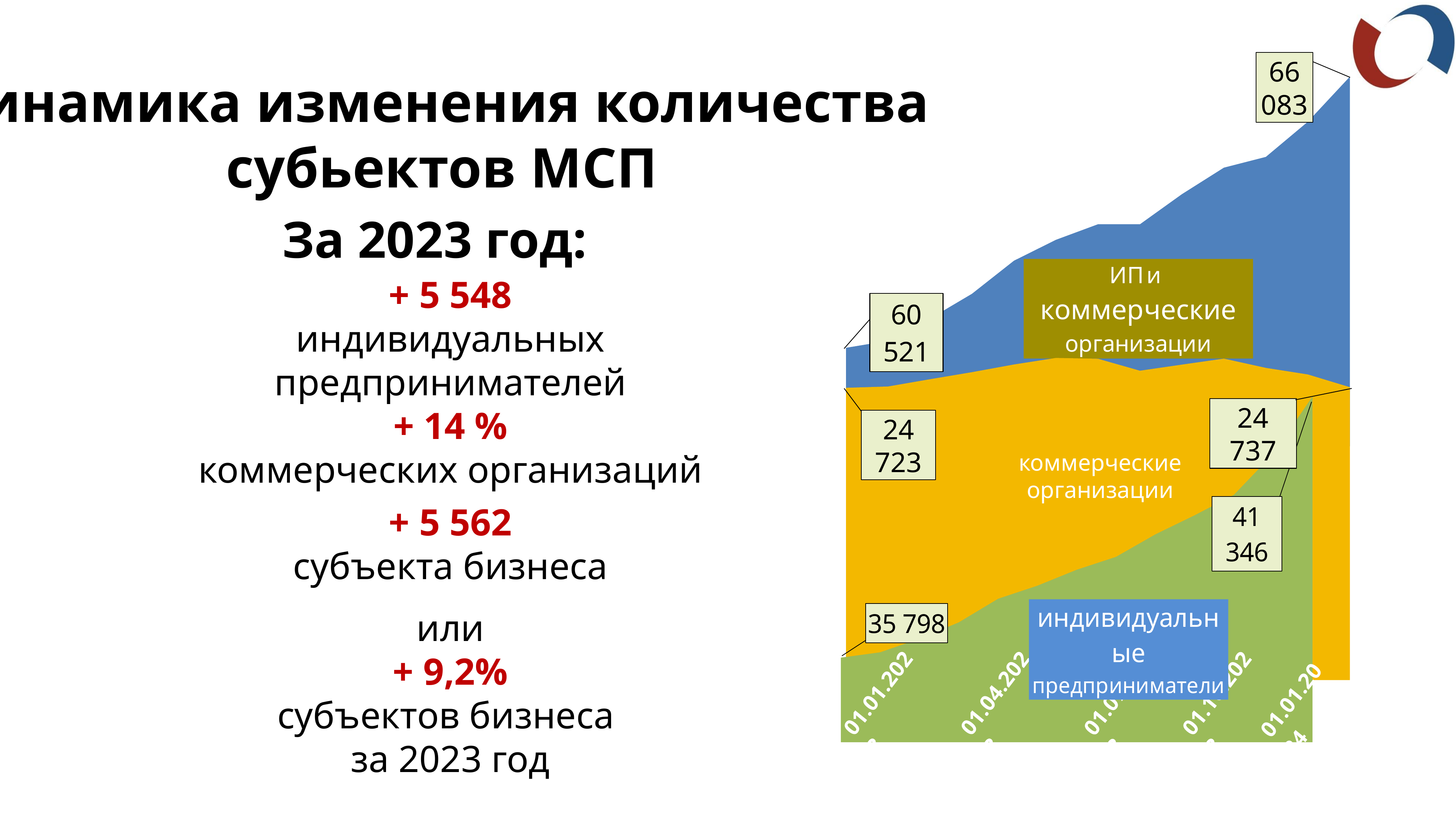
By how much did the number of commercial organizations change between the first and last points of the chart? 14 By how much did the number of individual entrepreneurs grow between the first and last points of the chart? 5 548 What is the number of individual entrepreneurs at the last point of the chart? 41 346 What is the number of commercial organizations at the last point of the chart? 24 737 What is the number of commercial organizations (коммерческие организации) at the first point of the chart? 24 723 At the first point of the chart, which is larger: the number of individual entrepreneurs or the number of commercial organizations? individual entrepreneurs What is the combined number of ИП и коммерческие организации at the first point of the chart? 60 521 What kind of chart is shown on the slide? area chart What is the combined number of ИП и коммерческие организации at the last point of the chart? 66 083 By how much did the combined number of ИП и коммерческие организации grow between the first and last points of the chart? 5 562 What is the number of individual entrepreneurs (индивидуальные предприниматели) at the first point of the chart? 35 798 Does the number of individual entrepreneurs rise or fall along the x axis of the chart? rise